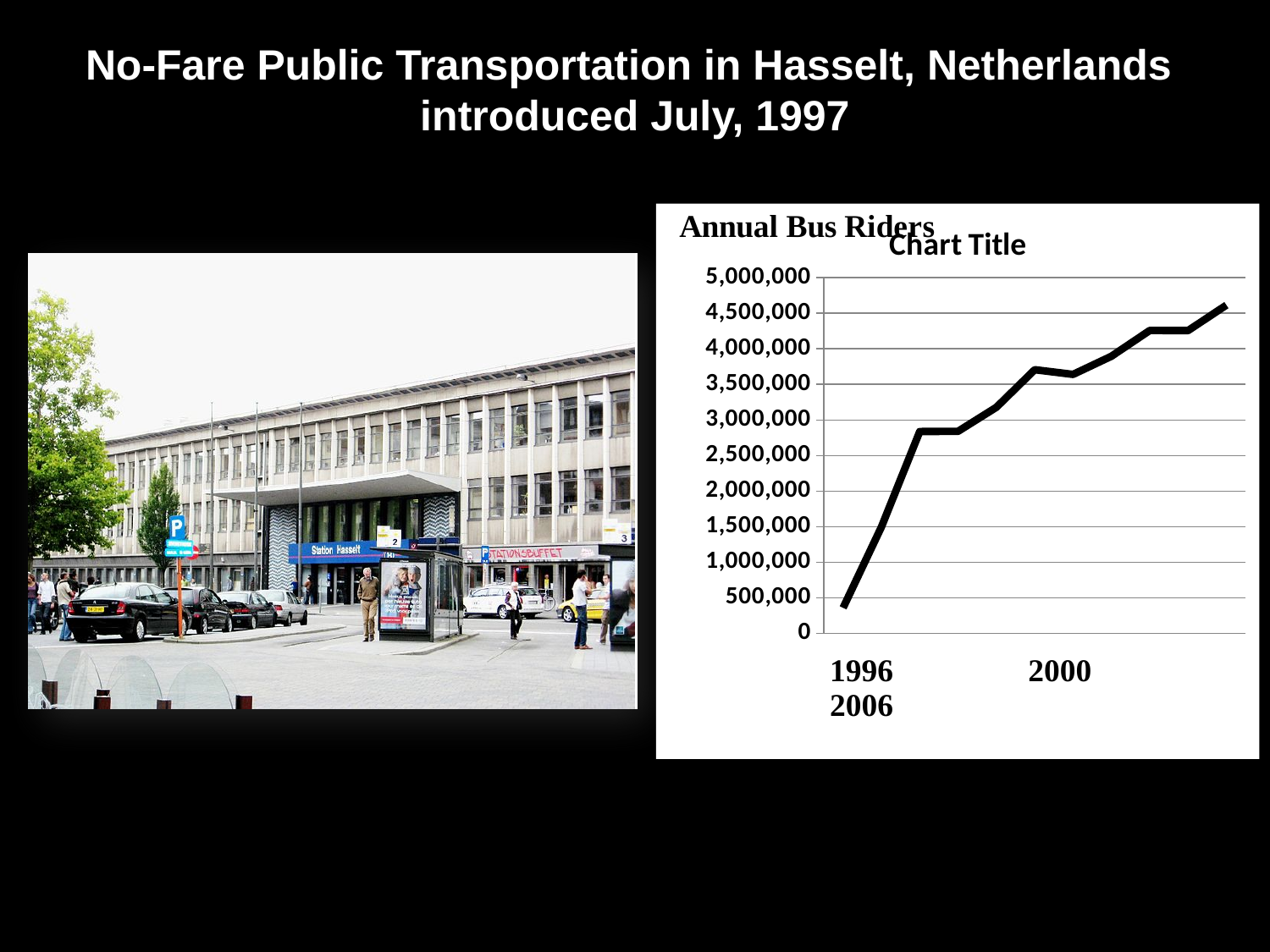
What kind of chart is shown on the slide? line chart Do the annual bus rider values generally rise or fall from 1996 onward? rise Is the value for 2000 greater or less than 4,000,000? less Is the value for 1996 greater or less than 500,000? less Is the value for 1996 greater or less than 1,000,000? less What label appears above the chart describing the data? Annual Bus Riders Which year shown on the x axis has the lower value, 1996 or 2000? 1996 What is the highest tick value shown on the y axis? 5,000,000